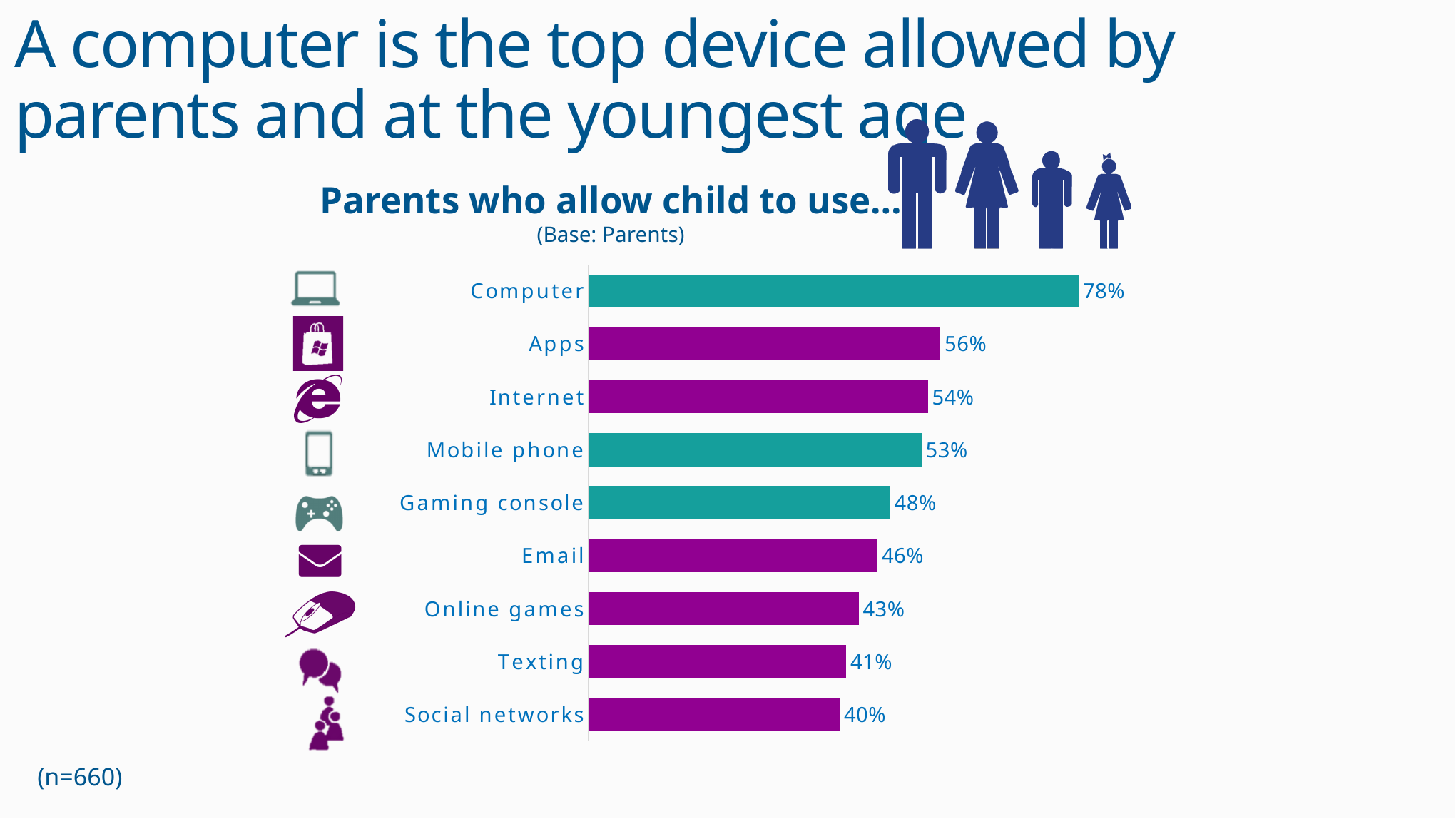
What percentage of parents allow their child to use a computer? 78% What is the difference between the values for Computer and Apps? 22% Which category has the lowest value? Social networks Which category has the highest value? Computer What is the value for Social networks? 40% How many categories are shown in the chart? 9 What is the difference between the values for Email and Texting? 5% What kind of chart is shown on the slide? Bar chart What is the title of the chart? Parents who allow child to use... Which is larger, the value for Internet or the value for Online games? Internet What is the sample size (n) noted on the slide? 660 What is the value for Gaming console? 48%